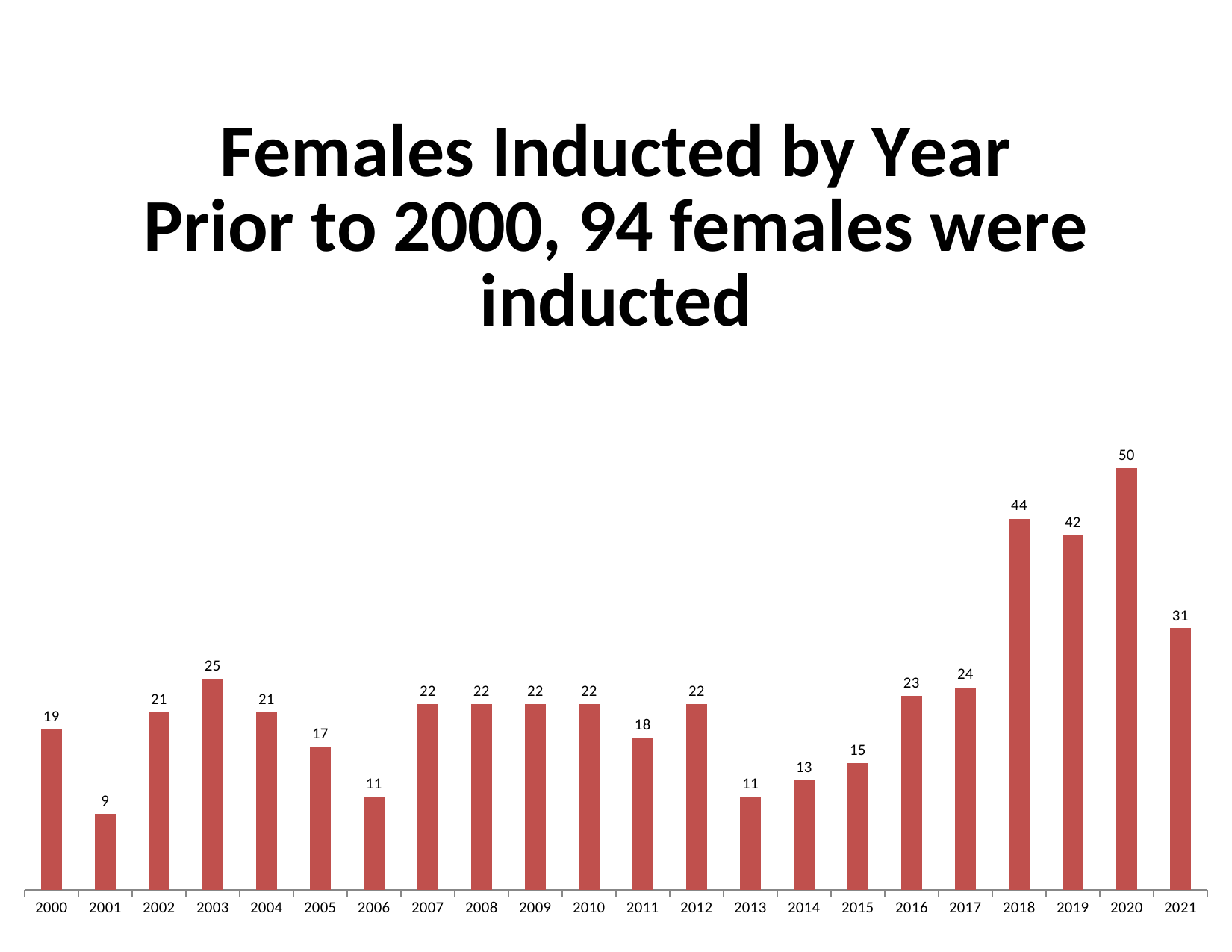
Which year has a larger value, 2013 or 2015? 2015 How many females were inducted in 2018? 44 How many females were inducted in 2020? 50 What kind of chart is shown on the slide? Bar chart Which year has the lowest number of females inducted? 2001 What is the value shown for 2001? 9 What is the difference between the values for 2020 and 2021? 19 Which year has a larger value, 2003 or 2017? 2003 What is the difference between the values for 2018 and 2019? 2 Which year has the highest number of females inducted? 2020 How many years are shown on the x axis? 22 Do the values rise or fall from 2016 to 2020? Rise